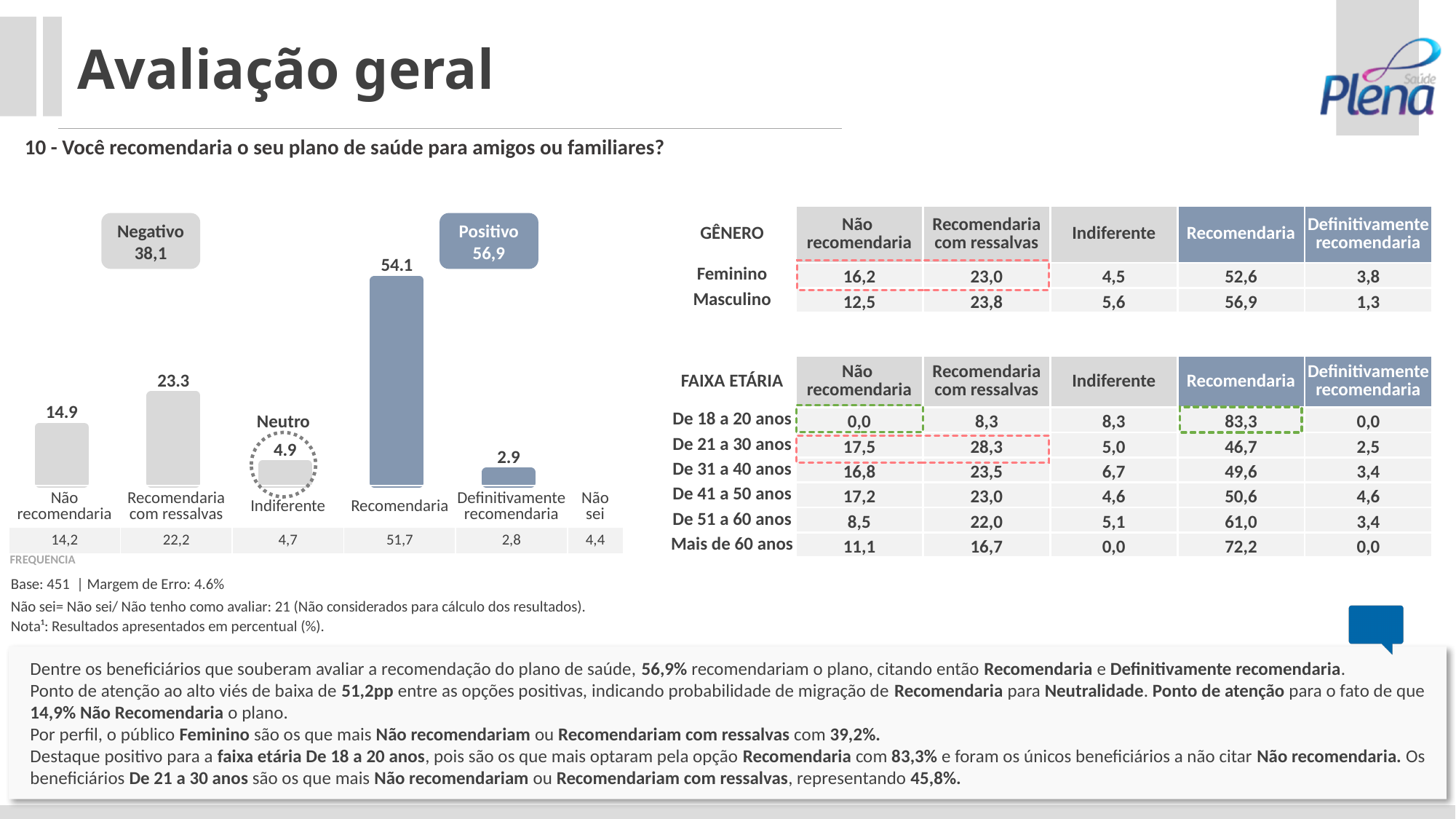
What is the difference between the values for Recomendaria and Não recomendaria in the bar chart? 39.2 What is the value shown for Definitivamente recomendaria in the bar chart? 2.9 What value is shown in the Positivo box above the bar chart? 56,9 Which category has the highest value in the bar chart? Recomendaria What is the value shown for Indiferente in the bar chart? 4.9 What is the value shown for Não recomendaria in the bar chart? 14.9 How many bars are plotted in the bar chart? 5 Which category has the lowest value in the bar chart? Definitivamente recomendaria What is the difference between the values for Recomendaria com ressalvas and Não recomendaria in the bar chart? 8.4 What is the value shown for Recomendaria in the bar chart? 54.1 What kind of chart is shown on the left of the slide? Bar chart Which is larger in the bar chart, Recomendaria com ressalvas or Indiferente? Recomendaria com ressalvas